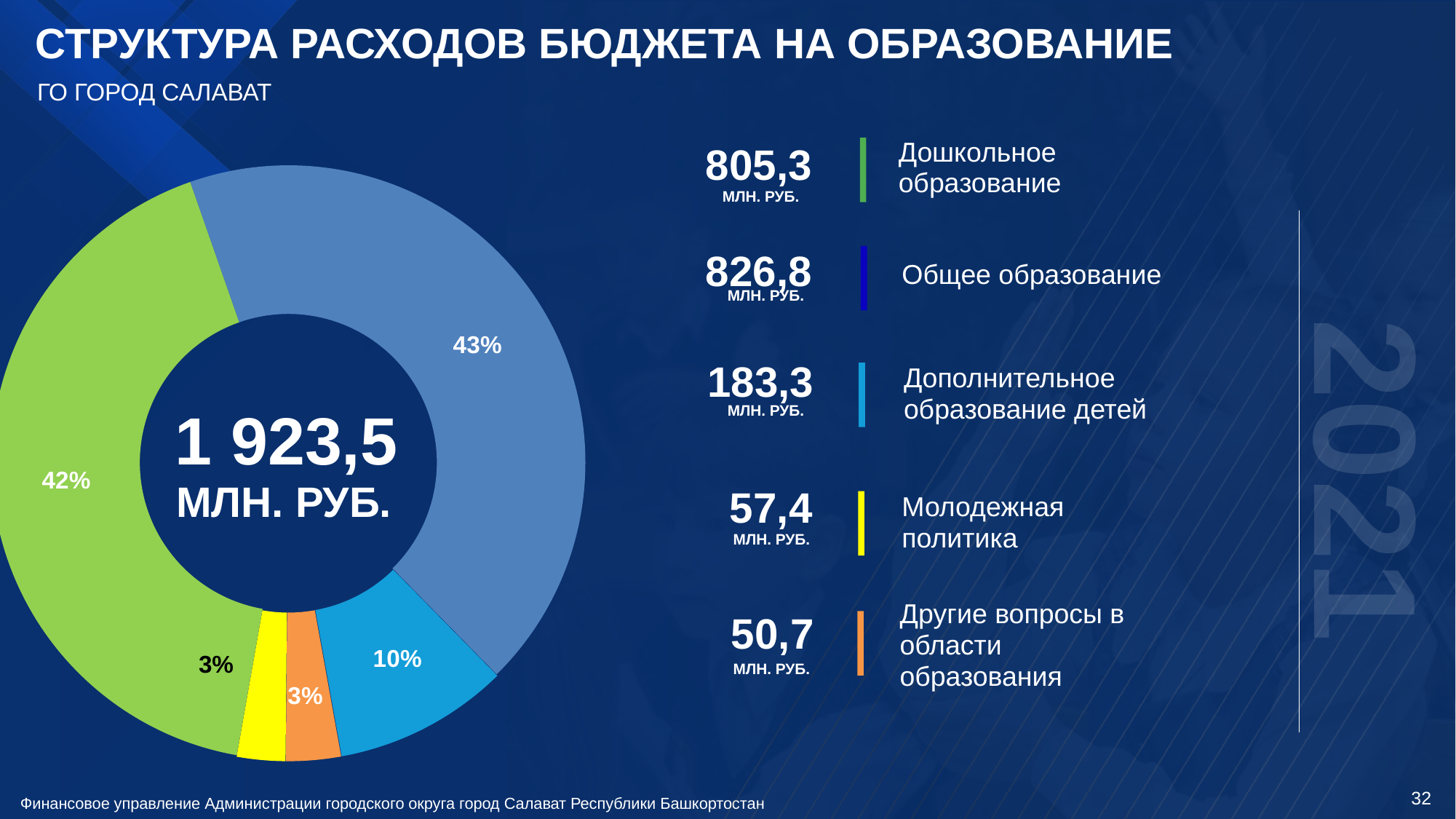
What share of the donut chart does the largest slice represent? 43% What share of the donut chart does the green slice (Дошкольное образование) represent? 42% What is the value for Дополнительное образование детей? 183,3 млн. руб. How many categories are shown in the chart? 5 What is the difference between Общее образование and Дошкольное образование? 21,5 млн. руб. What is the value for Дошкольное образование? 805,3 млн. руб. What is the value for Молодежная политика? 57,4 млн. руб. What is the value for Общее образование? 826,8 млн. руб. What type of chart is shown on the slide? Donut (pie) chart Which category has the highest value? Общее образование Which category has the lowest value? Другие вопросы в области образования What is the total value shown in the centre of the donut chart? 1 923,5 млн. руб.